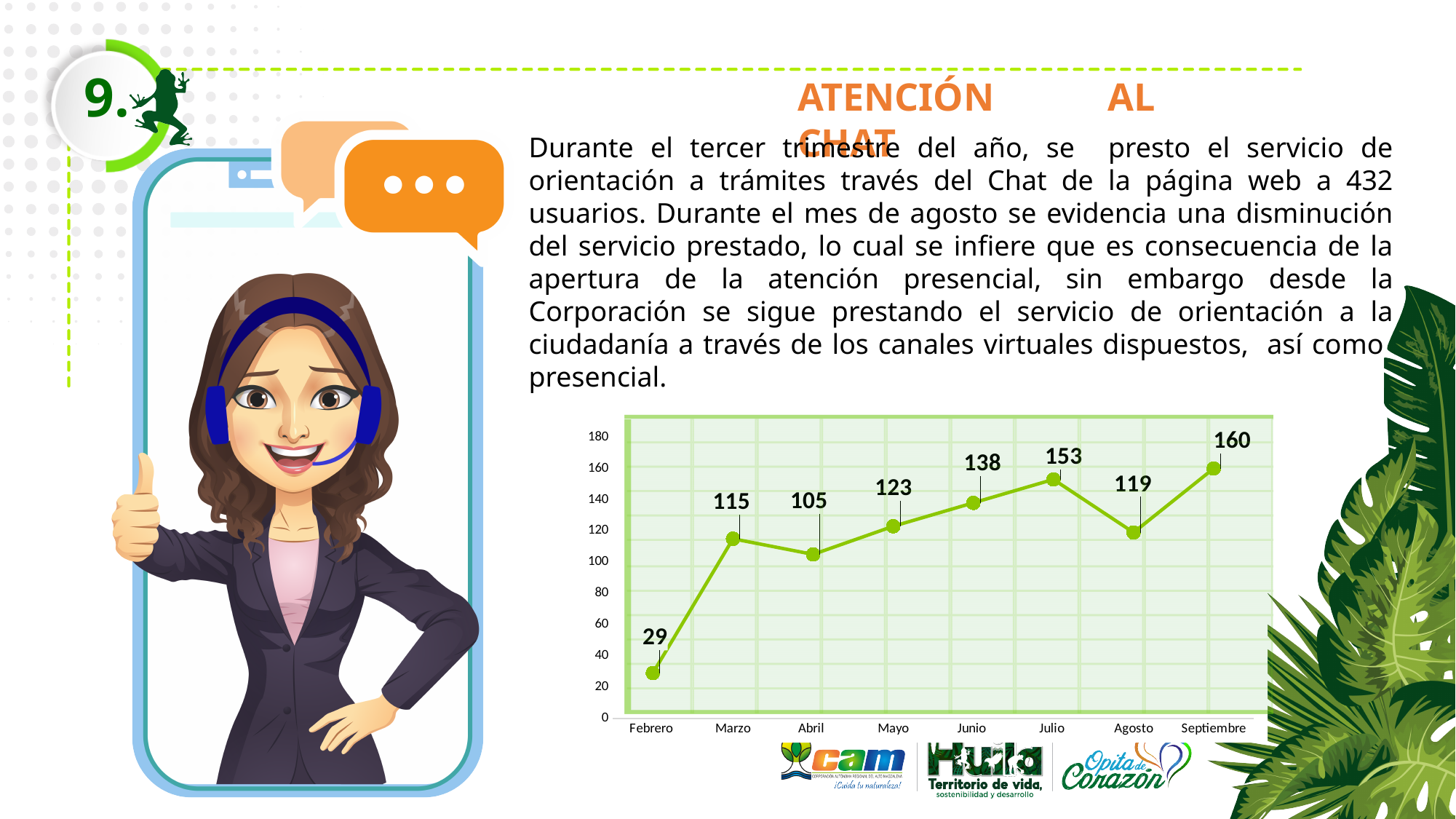
What is the value for Agosto? 119 Does the value rise or fall from Julio to Agosto? fall Which is larger, the value for Marzo or the value for Abril? Marzo What is the value for Febrero? 29 What kind of chart is shown on the slide? line chart What is the difference between the values for Septiembre and Febrero? 131 Which month has the lowest value? Febrero What is the difference between the values for Julio and Agosto? 34 Which month has the highest value? Septiembre How many months are plotted on the chart? 8 Is the value for Junio greater or less than 120? greater What is the value for Julio? 153